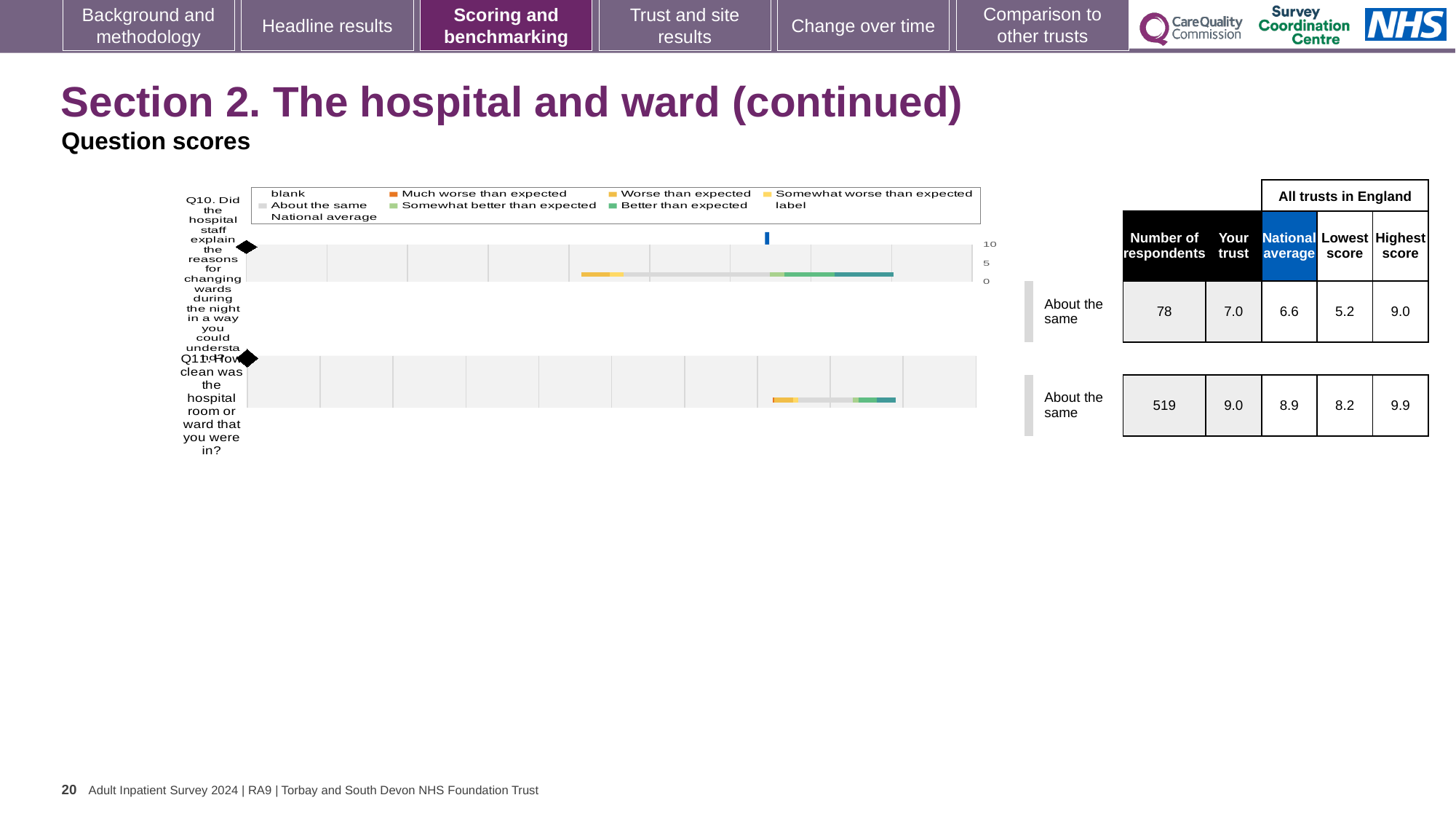
How many survey questions are charted on this slide? 2 How many respondents answered Q11? 519 What is the difference between the 'Your trust' score and the national average for Q11? 0.1 What is the national average score for Q10? 6.6 What is the lowest score across all trusts in England for Q10? 5.2 What is the 'Your trust' score for Q10 (explaining reasons for changing wards during the night)? 7.0 What is the difference between the highest and lowest scores across all trusts for Q10? 3.8 What is the highest score across all trusts in England for Q11? 9.9 What kind of chart is used to show the question scores? Bar chart Which question has the higher 'Your trust' score, Q10 or Q11? Q11 What is the 'Your trust' score for Q11 (how clean was the hospital room or ward)? 9.0 What benchmarking category is shown for Q10? About the same